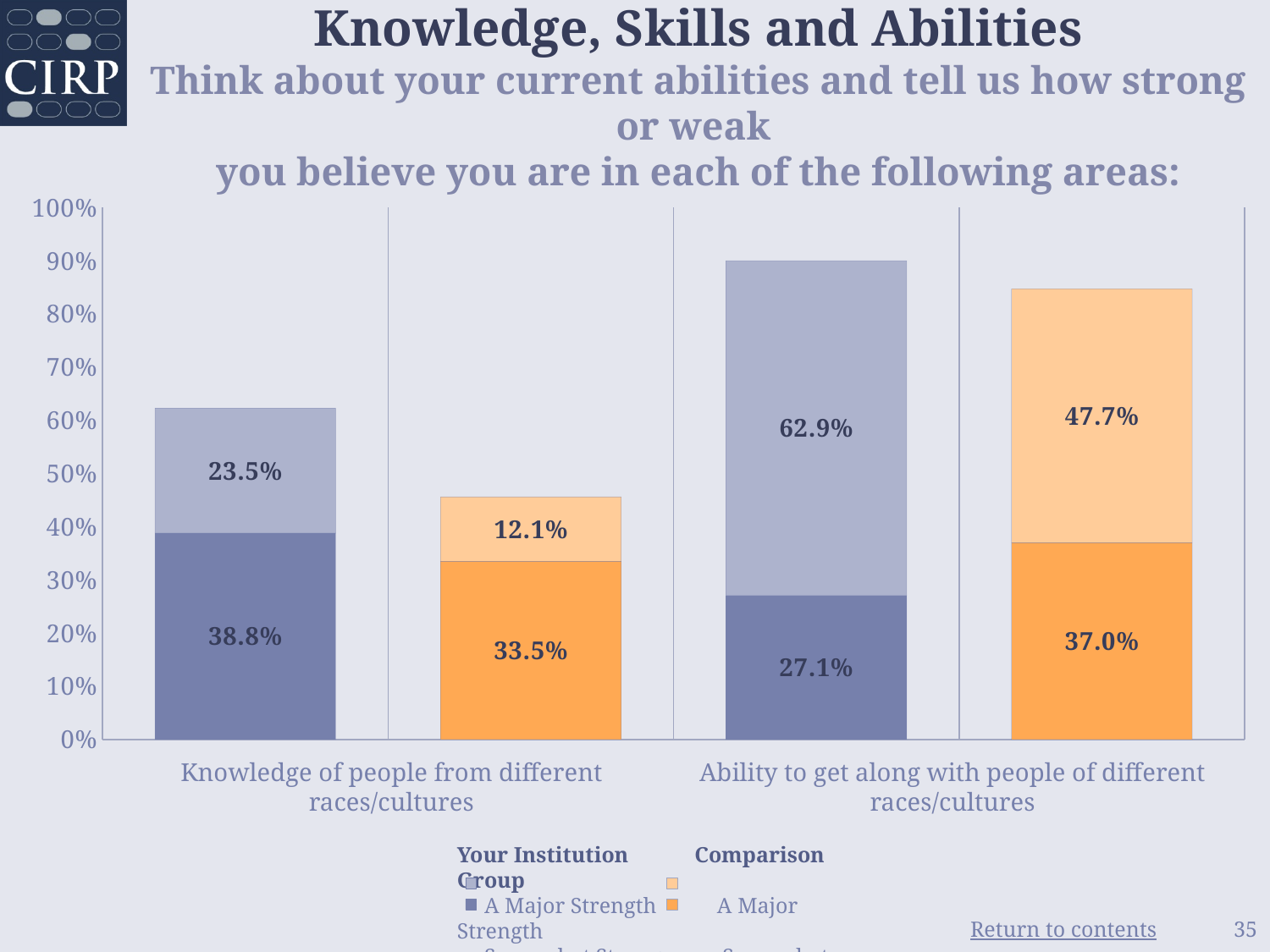
Which stacked bar has the highest total? Your Institution, Ability to get along with people of different races/cultures What is the total of the Your Institution stacked bar for 'Ability to get along with people of different races/cultures'? 90.0% How many categories are shown on the x axis? 2 Is the total of the Your Institution stacked bar for 'Knowledge of people from different races/cultures' greater or less than 50%? greater Which is larger for 'Ability to get along with people of different races/cultures': the 'A Major Strength' value for Your Institution or for the Comparison Group? Comparison Group What type of chart is shown on the slide? stacked bar chart What is the difference between the 'A Major Strength' values for Your Institution and the Comparison Group in 'Knowledge of people from different races/cultures'? 5.3% What is the value of the upper (lighter) segment of the Your Institution bar for 'Ability to get along with people of different races/cultures'? 62.9% What is the total of the Comparison Group stacked bar for 'Knowledge of people from different races/cultures'? 45.6% What is the 'A Major Strength' value for Your Institution in 'Knowledge of people from different races/cultures'? 38.8% What is the value of the upper (lighter) segment of the Comparison Group bar for 'Knowledge of people from different races/cultures'? 12.1% What is the 'A Major Strength' value for the Comparison Group in 'Ability to get along with people of different races/cultures'? 37.0%